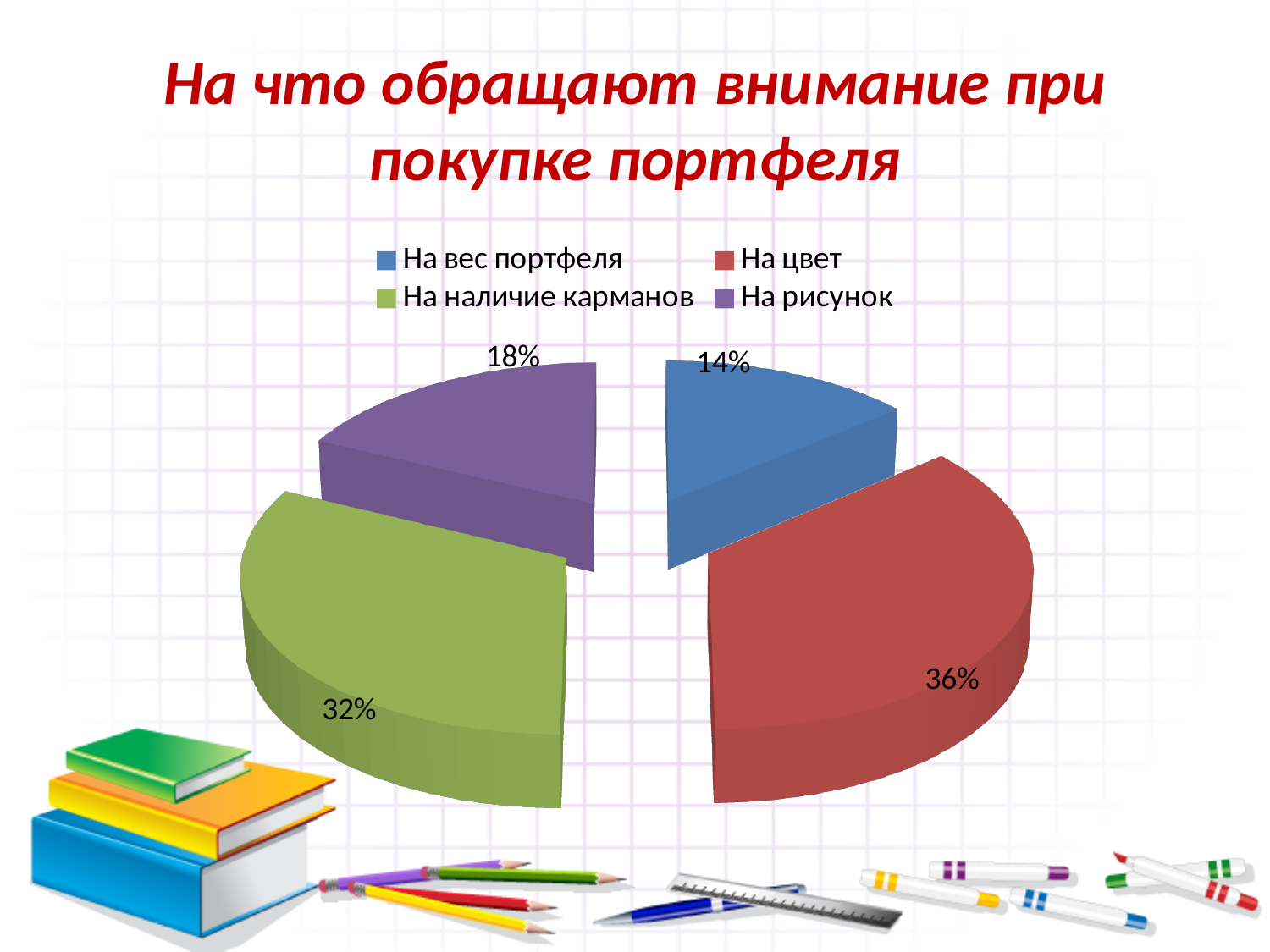
What is the difference between the shares for "На рисунок" and "На вес портфеля"? 4% What share of the pie does "На рисунок" take? 18% Which is larger: the share for "На рисунок" or the share for "На вес портфеля"? На рисунок What share of the pie does "На вес портфеля" take? 14% What kind of chart is shown on the slide? Pie chart Which category has the smallest slice of the pie? На вес портфеля How many categories does the pie chart have? 4 What share of the pie does "На наличие карманов" take? 32% What is the title of the slide containing the chart? На что обращают внимание при покупке портфеля What is the difference between the shares for "На цвет" and "На наличие карманов"? 4% Which category has the largest slice of the pie? На цвет